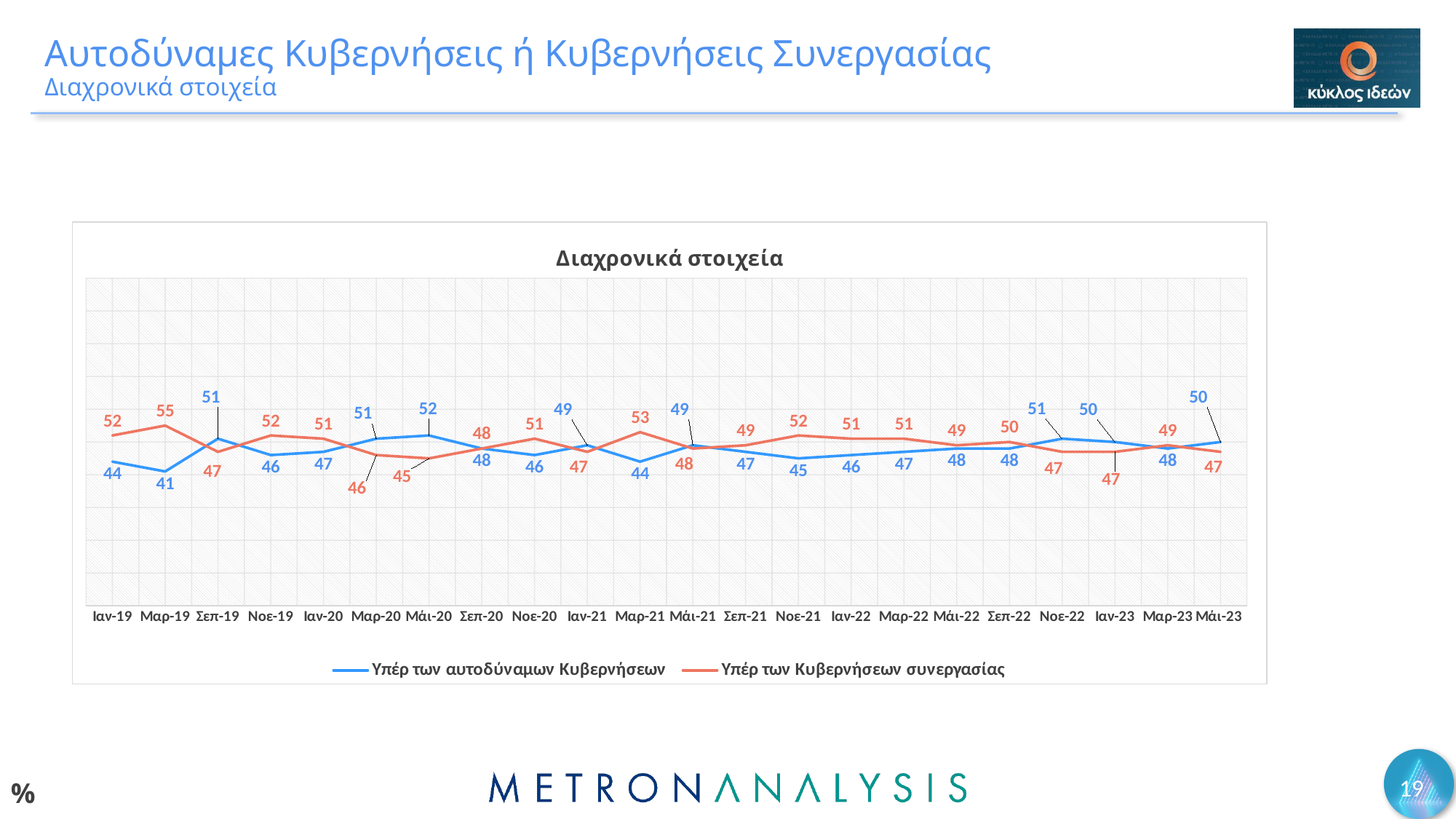
In which period does Υπέρ των Κυβερνήσεων συνεργασίας reach its highest value? Μαρ-19 What is the value for Υπέρ των Κυβερνήσεων συνεργασίας in Μαρ-21? 53 What is the value for Υπέρ των αυτοδύναμων Κυβερνήσεων in Μαρ-19? 41 What is the difference between the two series in Μαρ-19? 14 What is the title of the chart? Διαχρονικά στοιχεία In which period does Υπέρ των αυτοδύναμων Κυβερνήσεων reach its lowest value? Μαρ-19 How many series does the legend list? 2 How many time points are plotted along the x axis? 22 Which series has the larger value in Ιαν-19? Υπέρ των Κυβερνήσεων συνεργασίας What type of chart is shown on the slide? line chart What is the value for Υπέρ των αυτοδύναμων Κυβερνήσεων in Μάι-23? 50 In which period does Υπέρ των αυτοδύναμων Κυβερνήσεων reach its highest value? Μάι-20